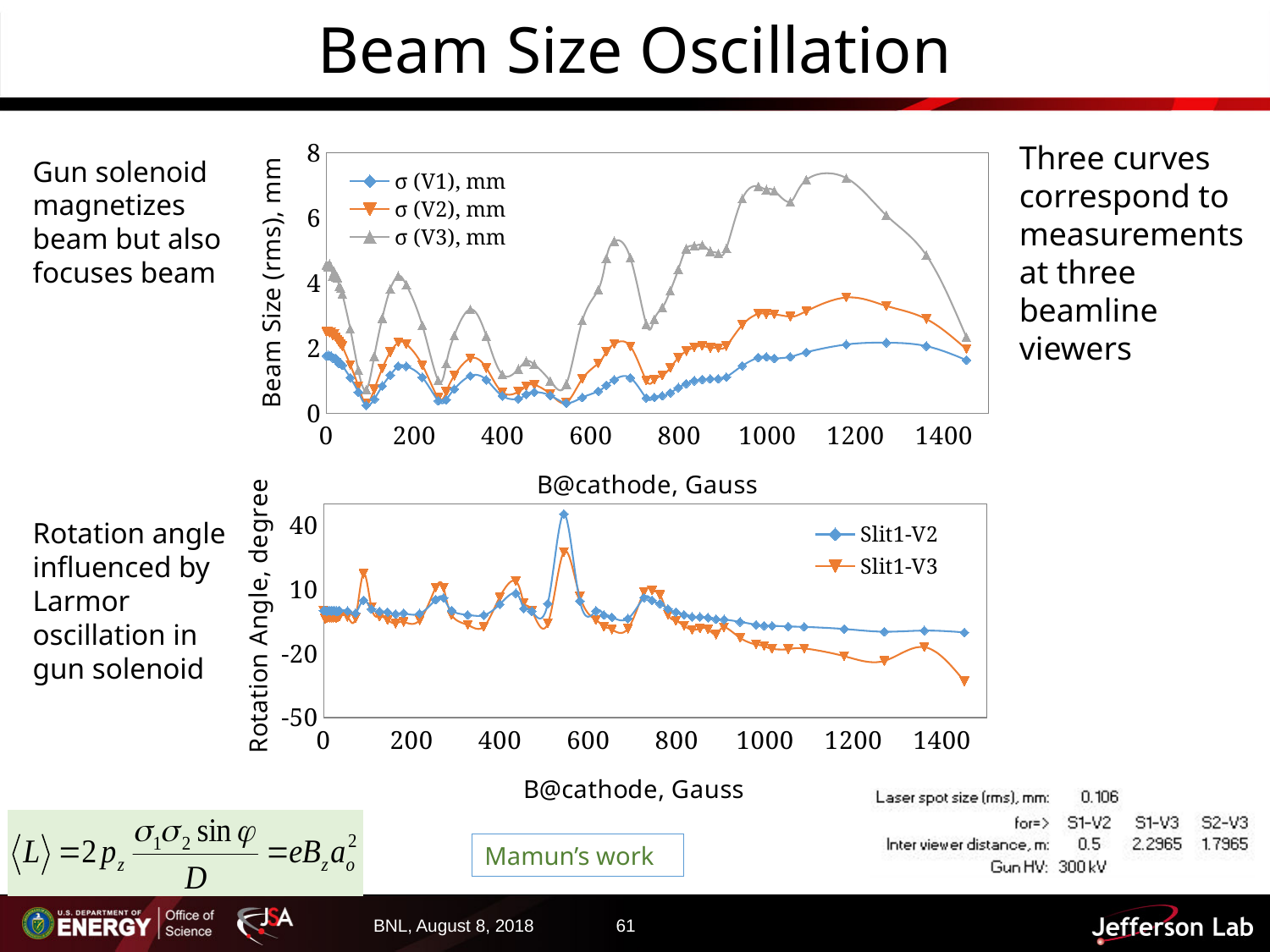
What kind of chart is the top chart (Beam Size)? Line chart On the bottom chart (Rotation Angle), is the peak value of Slit1-V2 near 550 Gauss greater or less than 40? greater On the top chart (Beam Size), at about 1200 Gauss, which is larger: σ (V3), mm or σ (V1), mm? σ (V3), mm On the top chart (Beam Size), is the value of σ (V3), mm at about 1200 Gauss greater or less than 6? greater On the bottom chart (Rotation Angle), which series has the higher peak near 550 Gauss: Slit1-V2 or Slit1-V3? Slit1-V2 On the bottom chart (Rotation Angle), how many series does the legend list? 2 What is the x-axis title of the top chart (Beam Size)? B@cathode, Gauss On the top chart (Beam Size), is the value of σ (V1), mm at about 100 Gauss greater or less than 2? less What is the y-axis title of the bottom chart? Rotation Angle, degree On the top chart (Beam Size), which series reaches the highest beam size? σ (V3), mm On the top chart (Beam Size), how many series does the legend list? 3